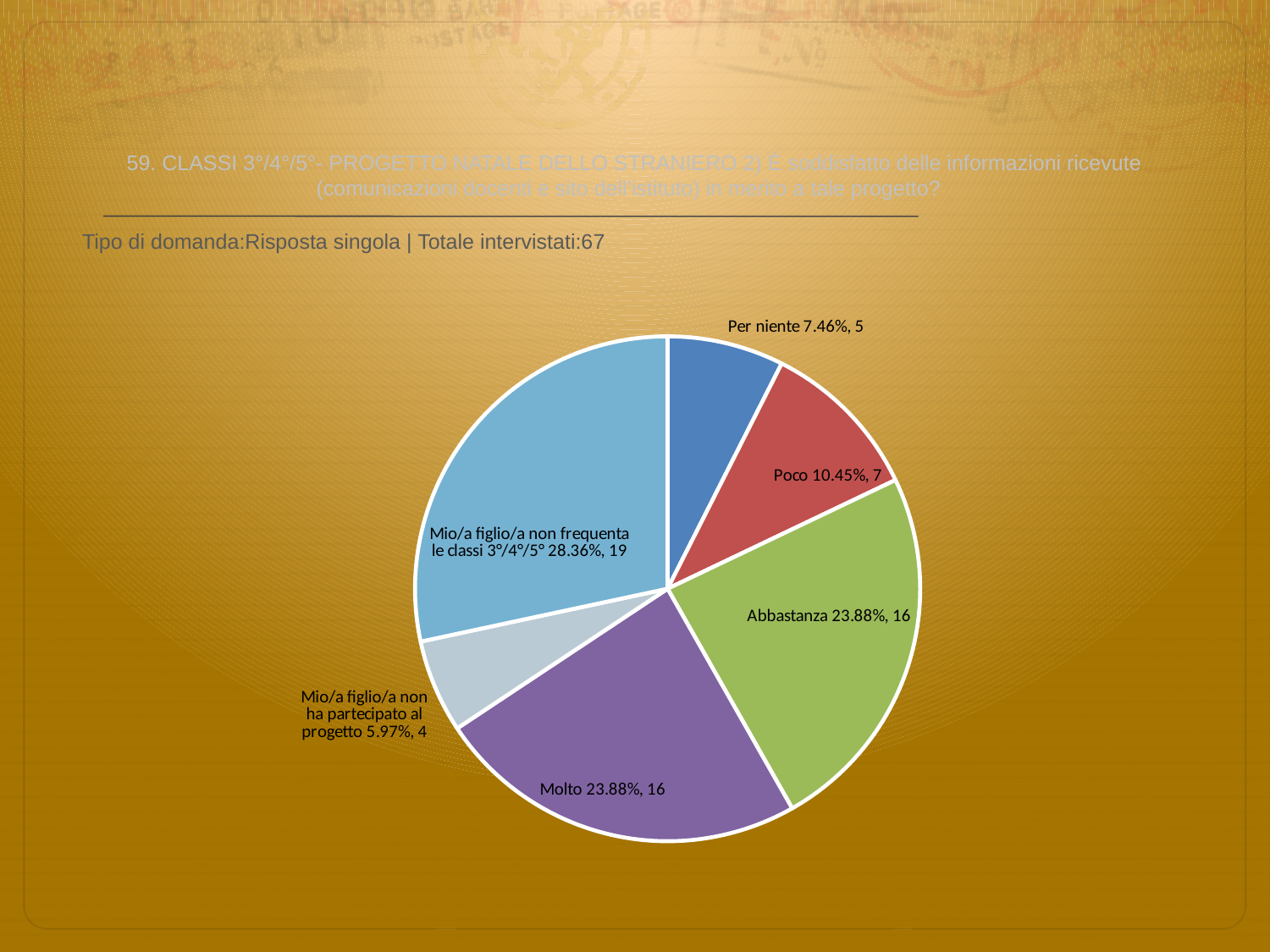
Which is larger, the count for 'Poco' or the count for 'Per niente'? Poco What is the difference in count between 'Mio/a figlio/a non frequenta le classi 3°/4°/5°' and 'Molto'? 3 What percentage is shown for 'Mio/a figlio/a non ha partecipato al progetto'? 5.97% What share of the pie does the 'Molto' slice represent? 23.88% What percentage is shown for the 'Poco' slice? 10.45% Which category has the largest slice of the pie? Mio/a figlio/a non frequenta le classi 3°/4°/5° Which category has the smallest slice of the pie? Mio/a figlio/a non ha partecipato al progetto What kind of chart is shown on the slide? pie chart What is the total number of respondents stated on the slide? 67 What is the count for the 'Abbastanza' slice? 16 What is the count for the 'Per niente' slice? 5 How many slices does the pie chart have? 6